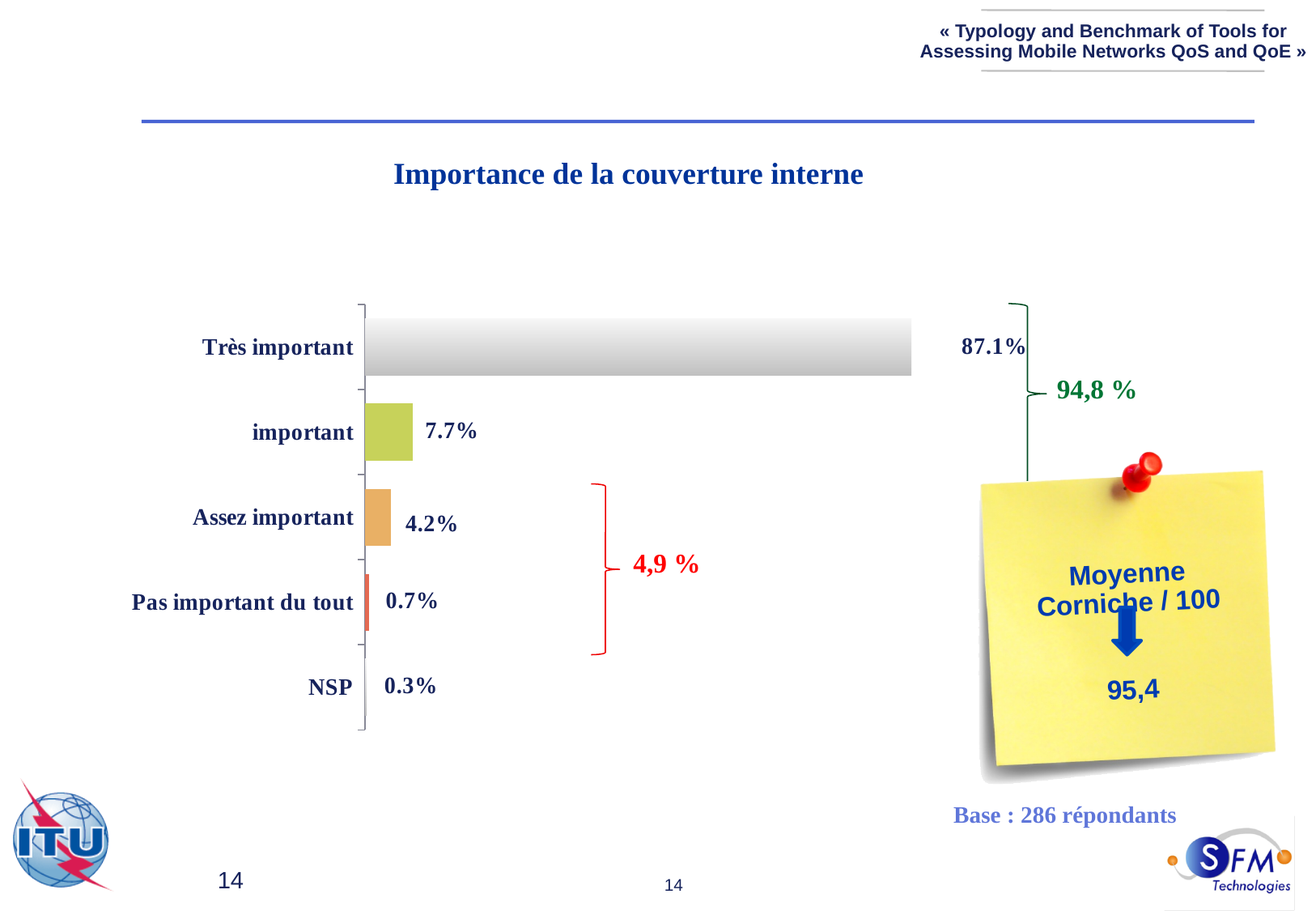
Which is larger, the value for "Assez important" or the value for "Pas important du tout"? Assez important How many categories are shown in the chart? 5 Which category has the highest value? Très important What is the title of the chart? Importance de la couverture interne What is the difference between the values for "important" and "Assez important"? 3.5% What kind of chart is shown on the slide? Bar chart What is the value for "important"? 7.7% What is the value for "Très important"? 87.1% What is the value for "NSP"? 0.3% What is the value for "Pas important du tout"? 0.7% Which category has the lowest value? NSP What is the value for "Assez important"? 4.2%